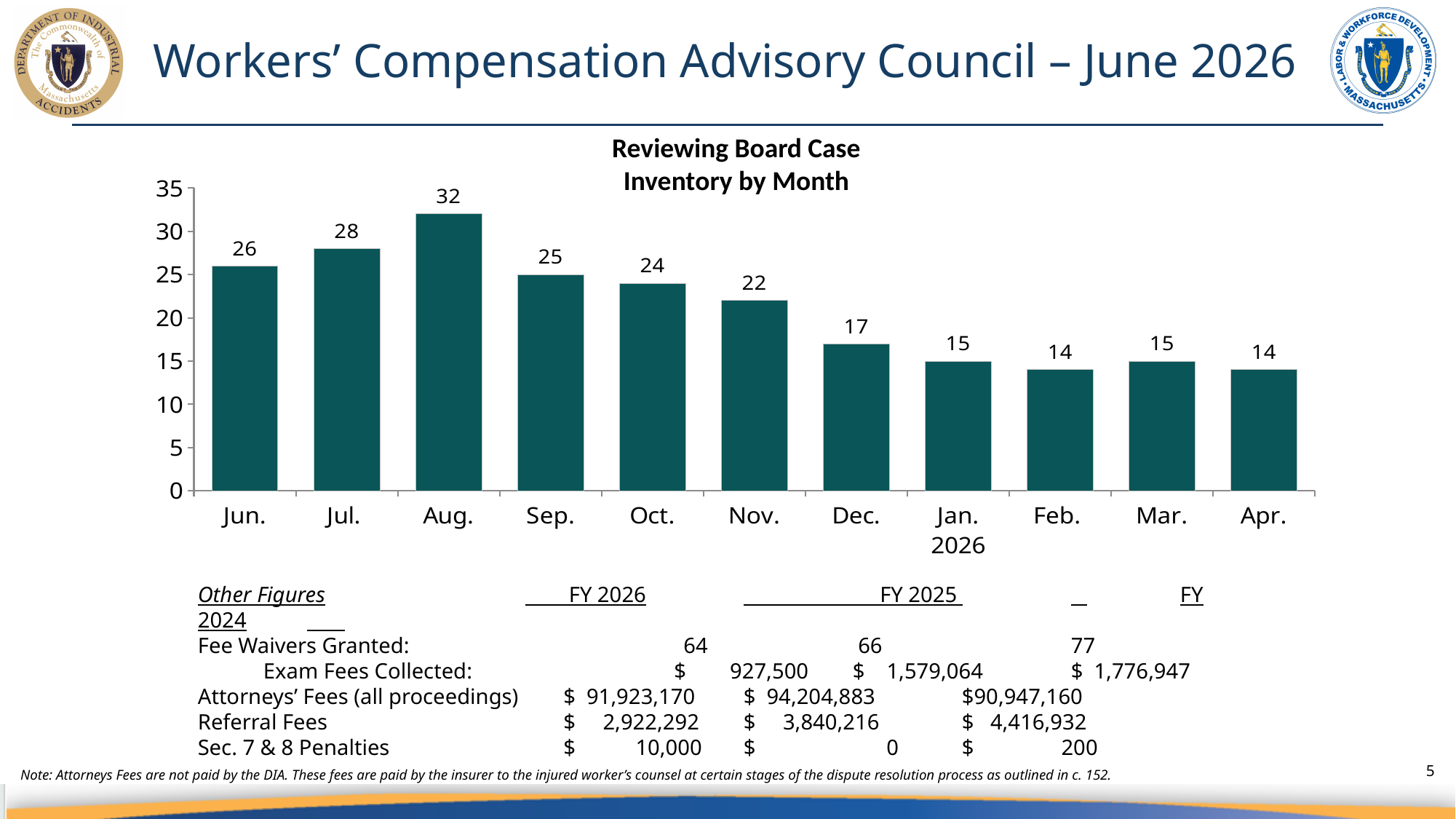
Is the case inventory for Oct. greater or less than 20? greater Which month has the highest Reviewing Board case inventory? Aug. Which is larger, the case inventory for Sep. or for Nov.? Sep. What is the difference between the case inventory in Aug. and in Apr.? 18 How many months are shown on the chart? 11 What is the difference between the case inventory in Jun. and in Jul.? 2 What is the title of the chart? Reviewing Board Case Inventory by Month What is the Reviewing Board case inventory for Jan. 2026? 15 What is the Reviewing Board case inventory for Aug.? 32 What kind of chart is shown on the slide? Bar chart From Aug. to Feb., does the case inventory rise or fall? Fall What is the Reviewing Board case inventory for Dec.? 17